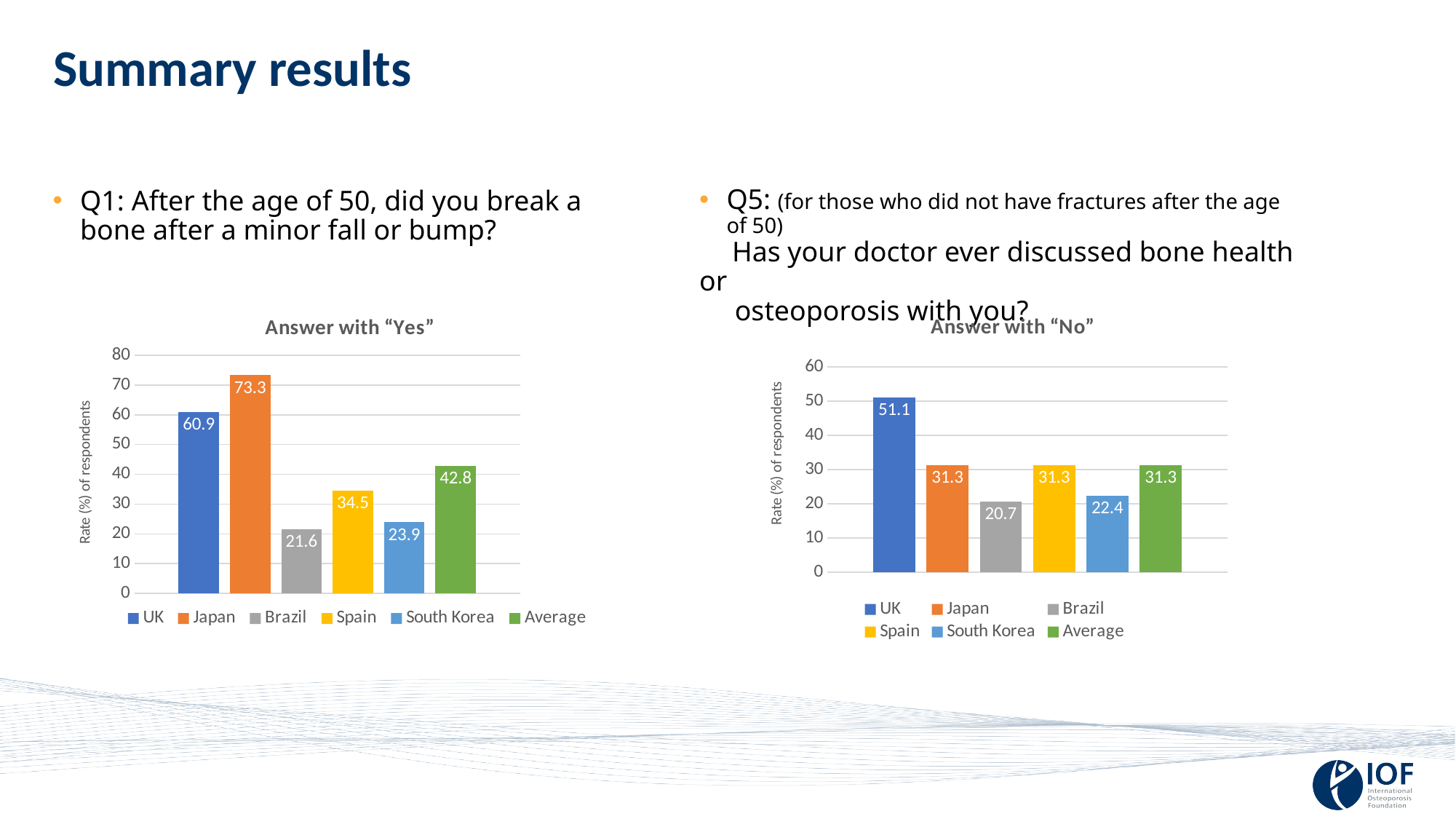
What kind of chart is the "Answer with "Yes"" chart? Bar chart In the "Answer with "No"" chart, which country has the lowest value? Brazil In the "Answer with "No"" chart, what is the value for the UK? 51.1 How many series does the legend of the "Answer with "No"" chart list? 6 In the "Answer with "Yes"" chart, what is the value for Japan? 73.3 In the "Answer with "No"" chart, what is the difference between the UK and Average values? 19.8 In the "Answer with "No"" chart, which is larger, the value for South Korea or the value for Brazil? South Korea In the "Answer with "Yes"" chart, what is the difference between the UK and Spain values? 26.4 What is the y-axis label of the "Answer with "Yes"" chart? Rate (%) of respondents In the "Answer with "Yes"" chart, what is the value for Average? 42.8 In the "Answer with "Yes"" chart, which country has the lowest value? Brazil In the "Answer with "Yes"" chart, which country has the highest value? Japan